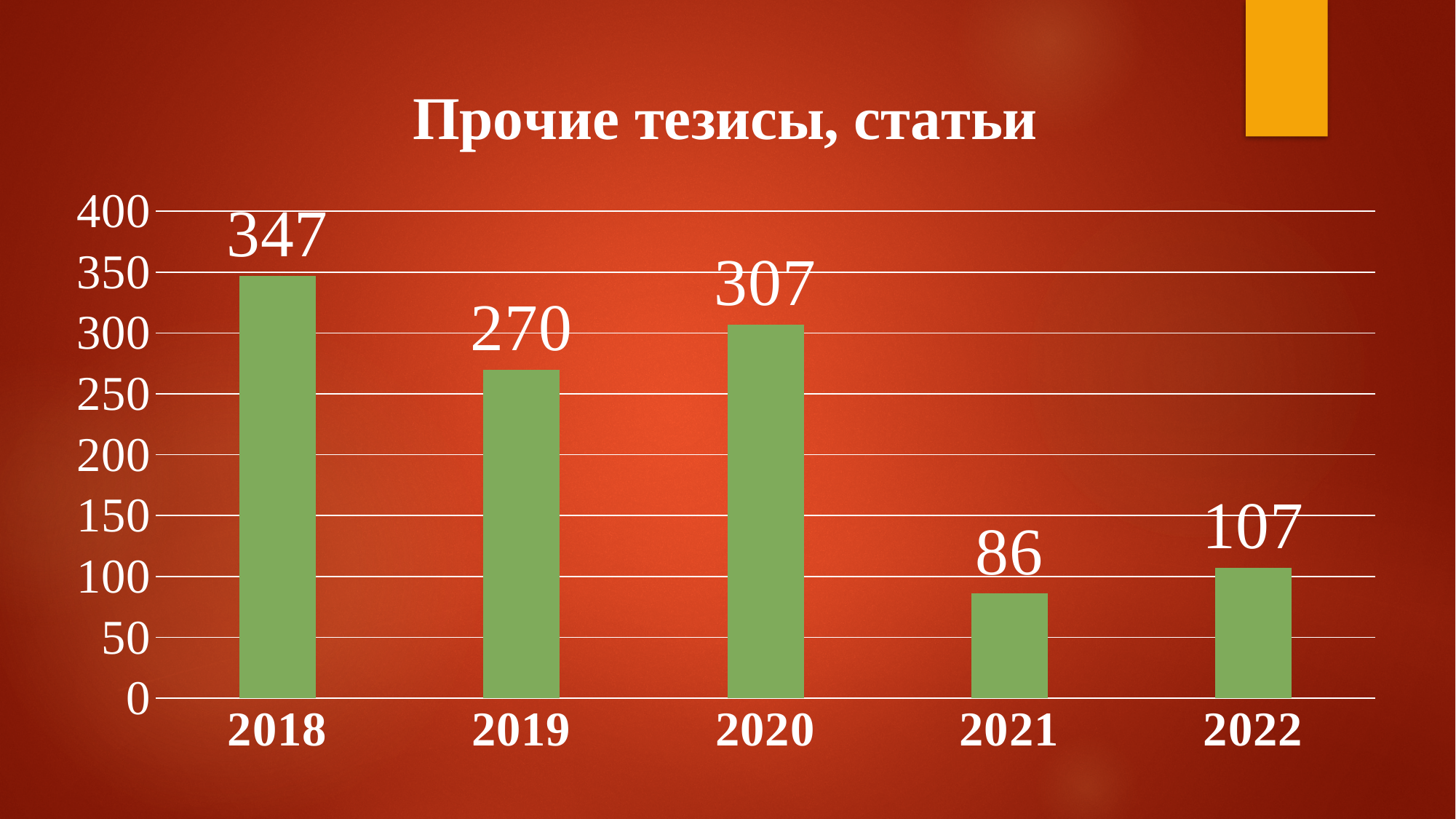
What kind of chart is shown on the slide? bar chart Which year has the lowest value? 2021 How many years are shown on the x axis? 5 What is the value for 2018? 347 What is the difference between the values for 2018 and 2019? 77 Which is larger, the value for 2019 or the value for 2020? 2020 What is the difference between the values for 2022 and 2021? 21 Is the value for 2020 greater or less than 300? greater What is the value for 2021? 86 What is the value for 2022? 107 What is the title of the chart? Прочие тезисы, статьи Which year has the highest value? 2018